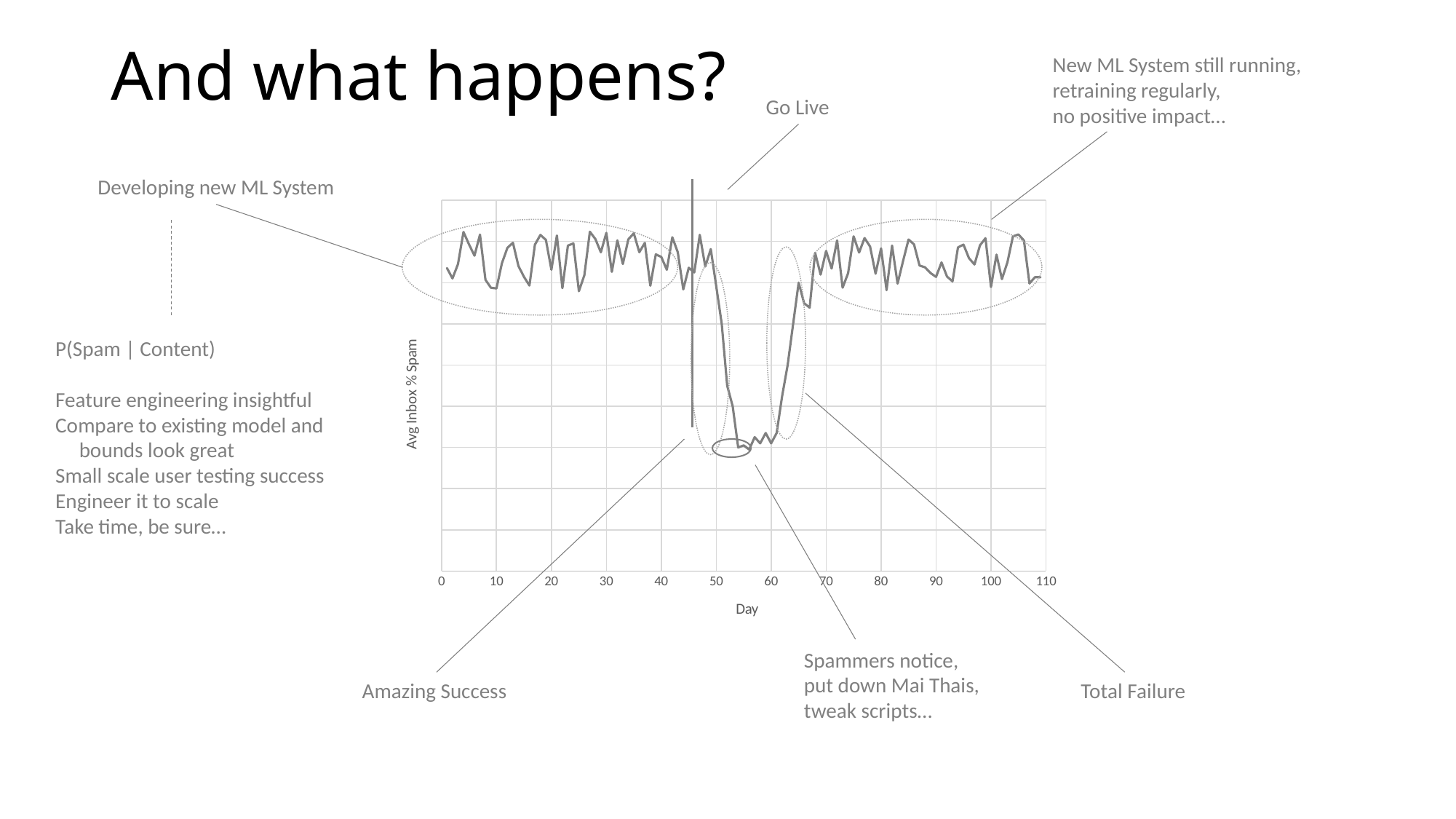
What kind of chart is shown on the slide? line chart Is the value of the line at day 55 higher or lower than its value at day 20? lower Does the line rise or fall between day 45 and day 55? fall How many tick labels are shown on the x axis? 12 What is the highest tick value shown on the x axis? 110 How many lines are plotted on the chart? 1 In which range of days does the line reach its lowest values? between day 50 and day 60 Does the sharp drop in the line occur before or after day 40 on the x axis? after Does the line rise or fall between day 60 and day 70? rise What is the lowest tick value shown on the x axis? 0 What is the label of the y axis of the chart? Avg Inbox % Spam What is the label of the x axis of the chart? Day